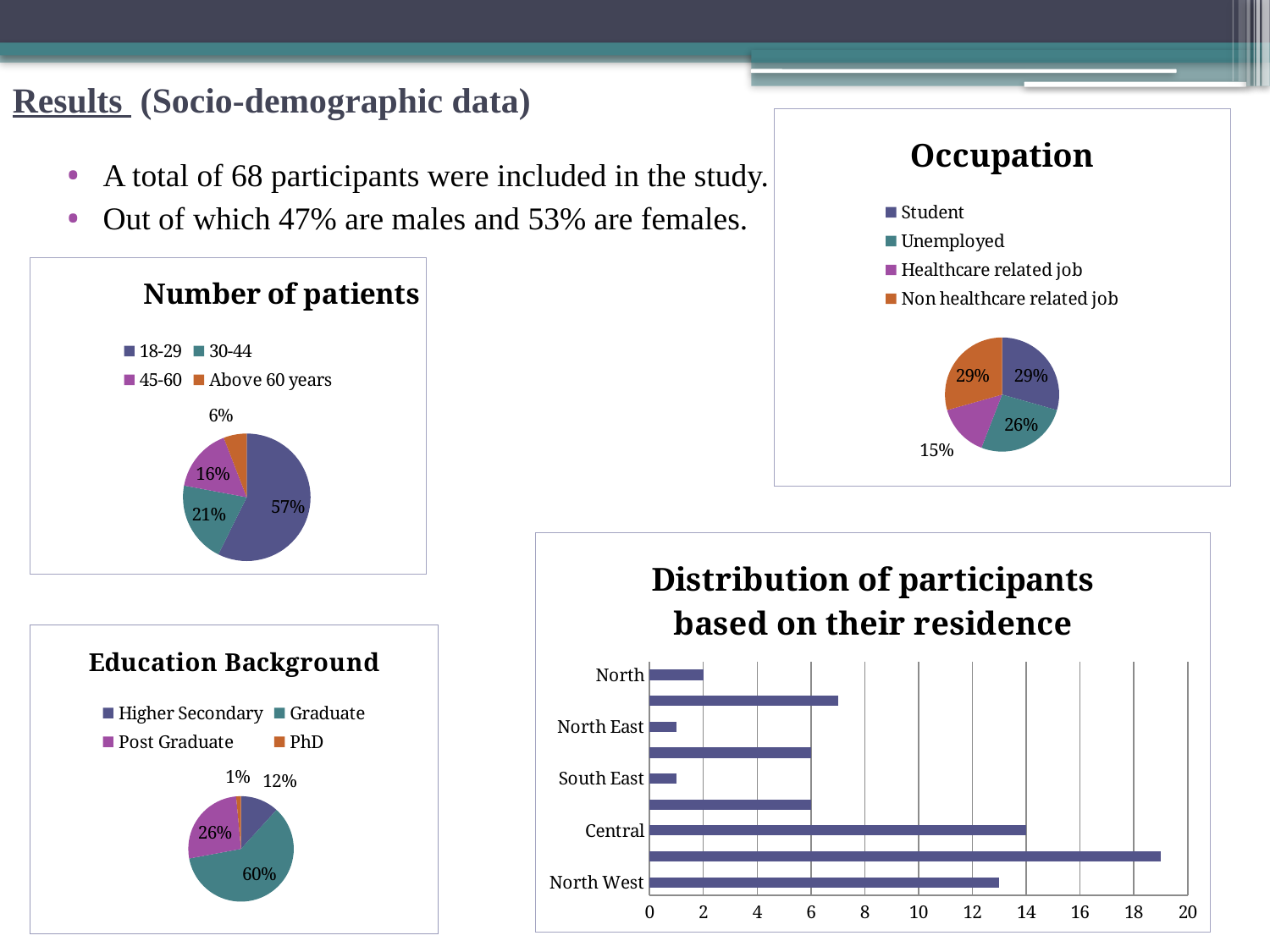
In the 'Education Background' pie chart, what percentage is shown for Graduate? 60% In the 'Distribution of participants based on their residence' chart, what is the value for North? 2 In the 'Number of patients' pie chart, which age group has the largest share? 18-29 In the 'Occupation' pie chart, what is the difference in percentage points between Unemployed and Healthcare related job? 11 percentage points In the 'Number of patients' pie chart, which age group has the smallest share? Above 60 years In the 'Number of patients' pie chart, what percentage is shown for the 18-29 age group? 57% What kind of chart is 'Distribution of participants based on their residence'? Bar chart In the 'Distribution of participants based on their residence' chart, is the value for North West greater or less than 12? greater In the 'Occupation' pie chart, what percentage is shown for Healthcare related job? 15% In the 'Education Background' pie chart, how many categories does the legend list? 4 In the 'Distribution of participants based on their residence' chart, what is the value for Central? 14 In the 'Education Background' pie chart, which is larger, Post Graduate or Higher Secondary? Post Graduate